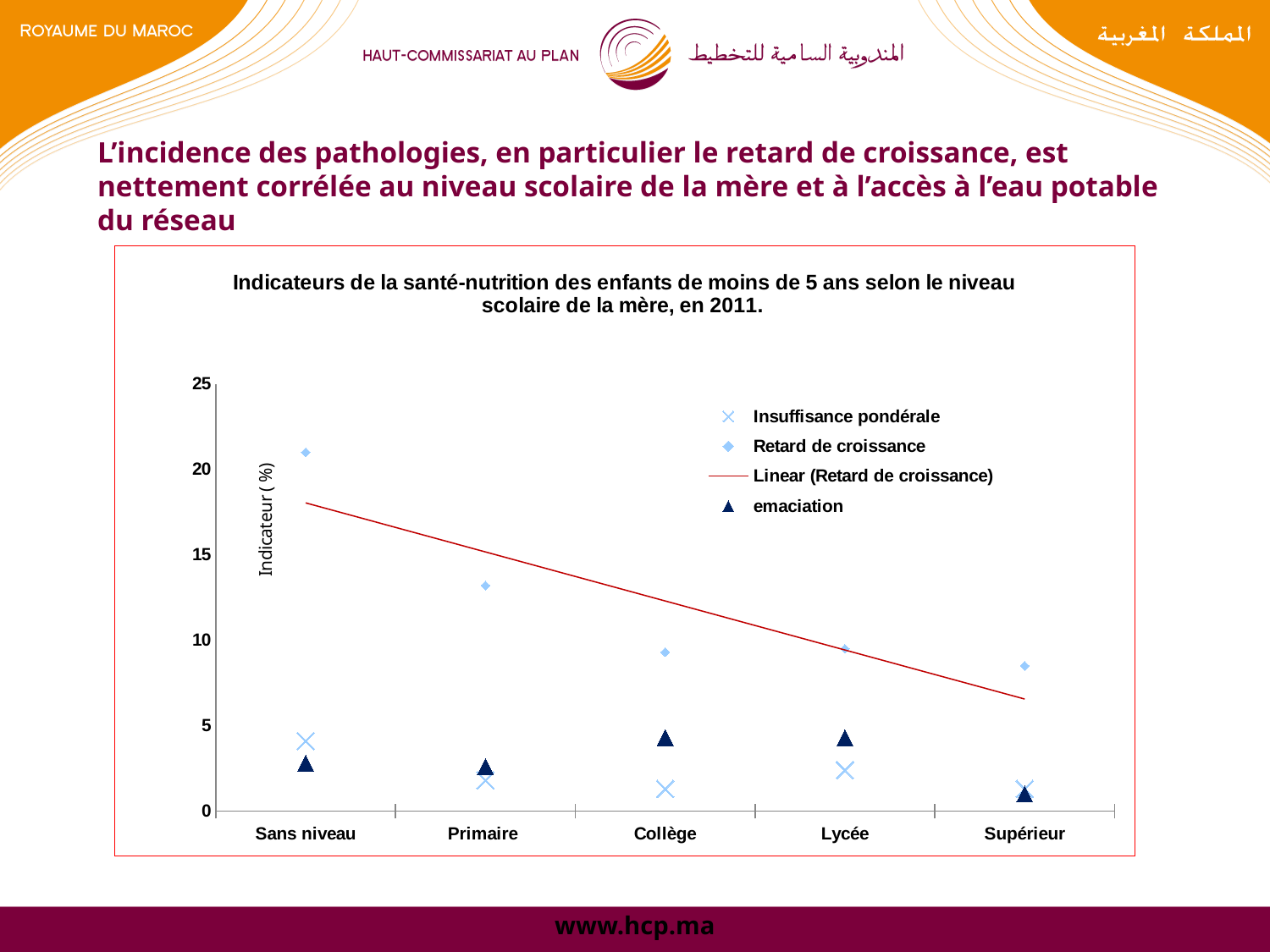
What is the label of the y axis? Indicateur ( %) Is the Retard de croissance value for Sans niveau greater or less than 20? greater Which is larger, Retard de croissance for Sans niveau or for Primaire? Sans niveau Is the Retard de croissance value for Primaire greater or less than 10? greater Is the Retard de croissance value for Supérieur greater or less than 10? less For which education level is Retard de croissance highest? Sans niveau What kind of chart is shown on the slide? scatter chart Does Retard de croissance rise or fall as the mother's education level increases from Sans niveau to Supérieur? fall For which education level is emaciation lowest? Supérieur For which education level is Insuffisance pondérale highest? Sans niveau How many categories of mother's education level are shown on the x axis? 5 How many entries does the legend list? 4